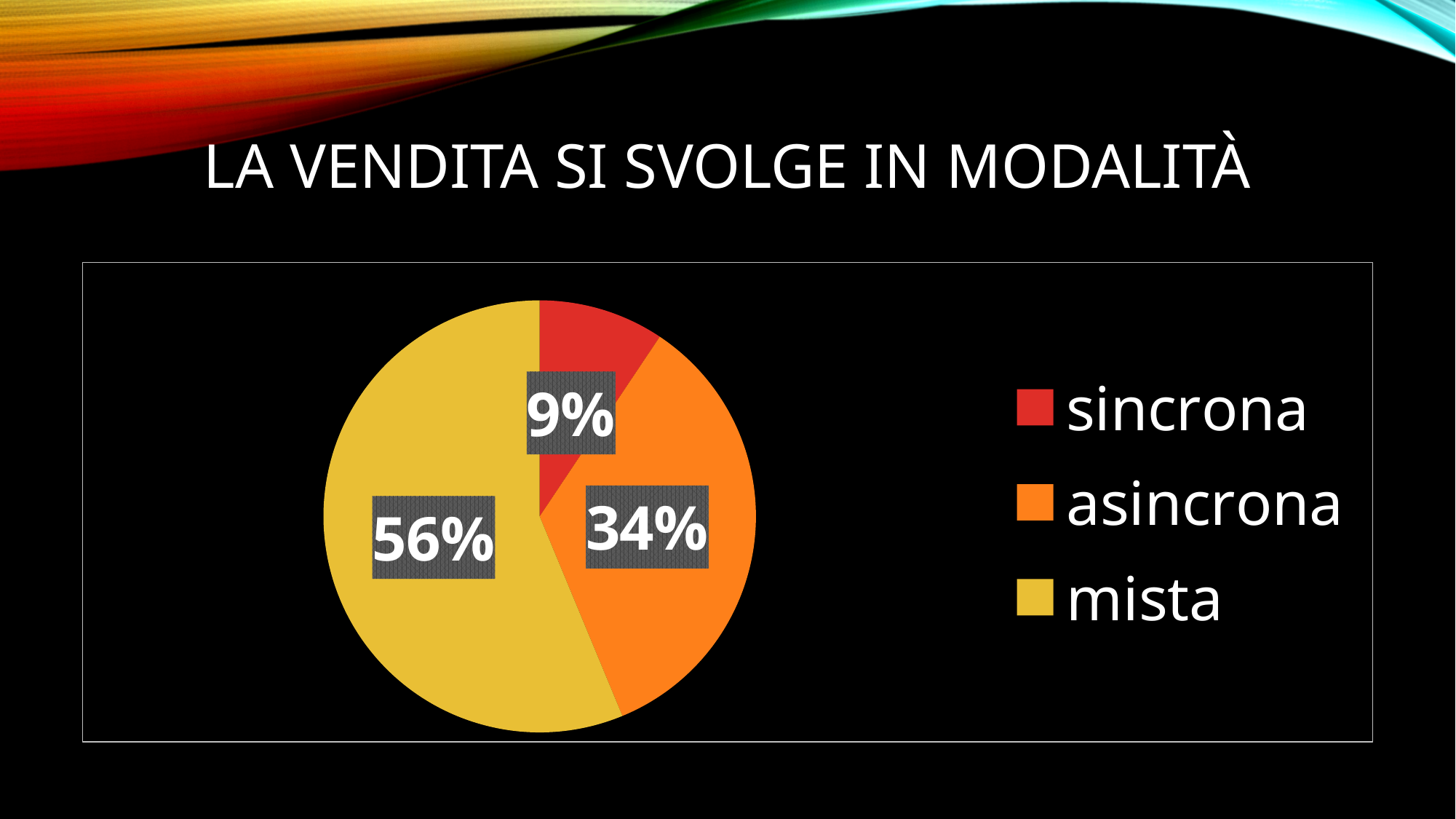
What kind of chart is shown on the slide? pie chart Which is larger, the slice for 'asincrona' or the slice for 'sincrona'? asincrona How many categories does the legend list? 3 What colour is the slice for 'sincrona'? red What percentage of the pie is labelled for 'sincrona'? 9% What percentage of the pie is labelled for 'asincrona'? 34% What percentage of the pie is labelled for 'mista'? 56% Which category has the smallest slice of the pie? sincrona Which category has the largest slice of the pie? mista What is the title of the slide above the chart? LA VENDITA SI SVOLGE IN MODALITÀ What is the difference in percentage points between 'mista' and 'asincrona'? 22 What is the difference in percentage points between 'asincrona' and 'sincrona'? 25